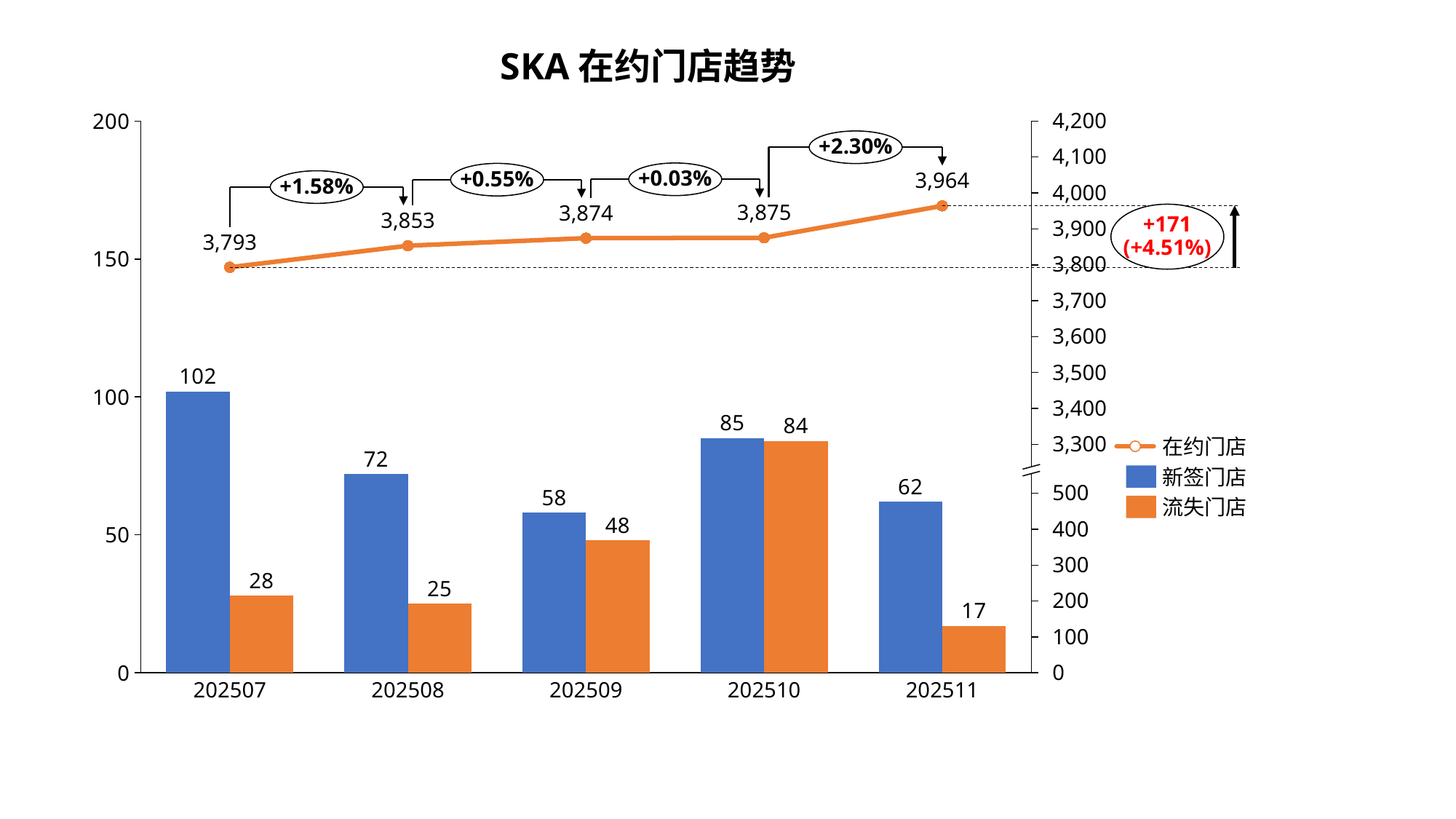
What is the title of the chart? SKA 在约门店趋势 Does the 在约门店 line rise or fall from 202507 to 202511? rise What is the value of 流失门店 for 202511? 17 What is the difference between 新签门店 and 流失门店 in 202508? 47 Which month has the highest 新签门店 value? 202507 What is the value of 新签门店 for 202507? 102 Which month has the lowest 流失门店 value? 202511 How many series does the legend list? 3 What is the value of 在约门店 for 202509? 3,874 Which is larger in 202510, 新签门店 or 流失门店? 新签门店 How many months are shown on the x axis? 5 What percentage change is labelled between 202510 and 202511 for 在约门店? +2.30%